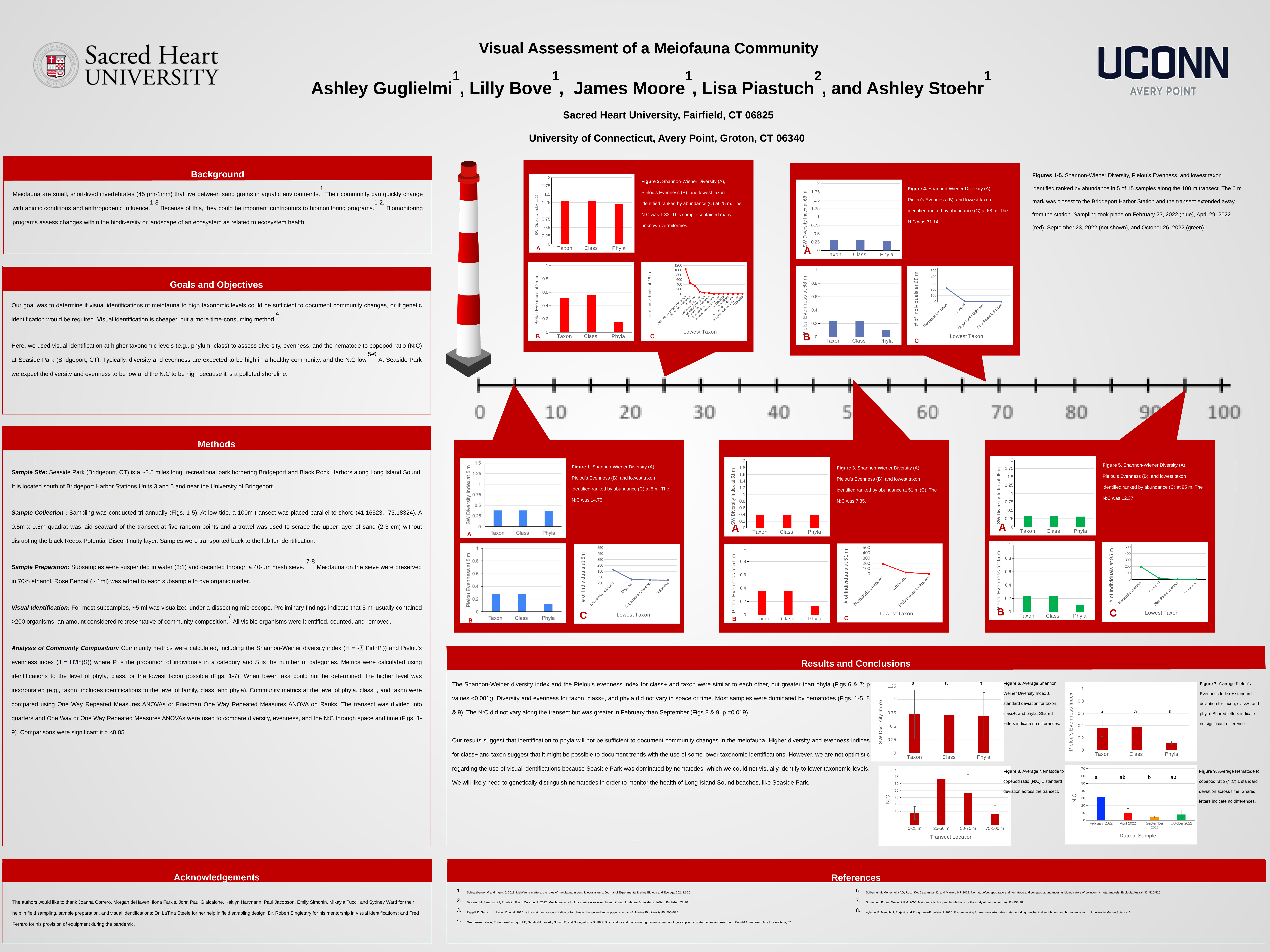
In Figure 7 (Average Pielou's Evenness Index), which category has the lowest value? Phyla In Figure 9 (Average N:C across time), which date of sample has the lowest N:C? September 2022 In Figure 3 panel B (Pielou Evenness at 51 m), which is larger, the value for Taxon or the value for Phyla? Taxon In Figure 7 (Average Pielou's Evenness Index), is the value for Phyla greater or less than 0.2? less In Figure 1 panel C (# of Individuals at 5 m), which lowest taxon has the most individuals? Nematoda Unknown In Figure 8 (Average N:C across the transect), is the value for 25-50 m greater or less than 30? greater In Figure 9 (Average N:C across time), which date of sample has the highest N:C? February 2022 In Figure 8 (Average Nematode to copepod ratio across the transect), which transect location has the highest N:C? 25-50 m In Figure 2 panel A (SW Diversity Index at 25 m), is the value for Taxon greater or less than 1? greater In Figure 9 (Average N:C across time), how many dates of sample are plotted? 4 What kind of chart is Figure 8 (Average N:C by transect location)? bar chart What kind of chart is Figure 4 panel C (# of Individuals at 68 m)? line chart